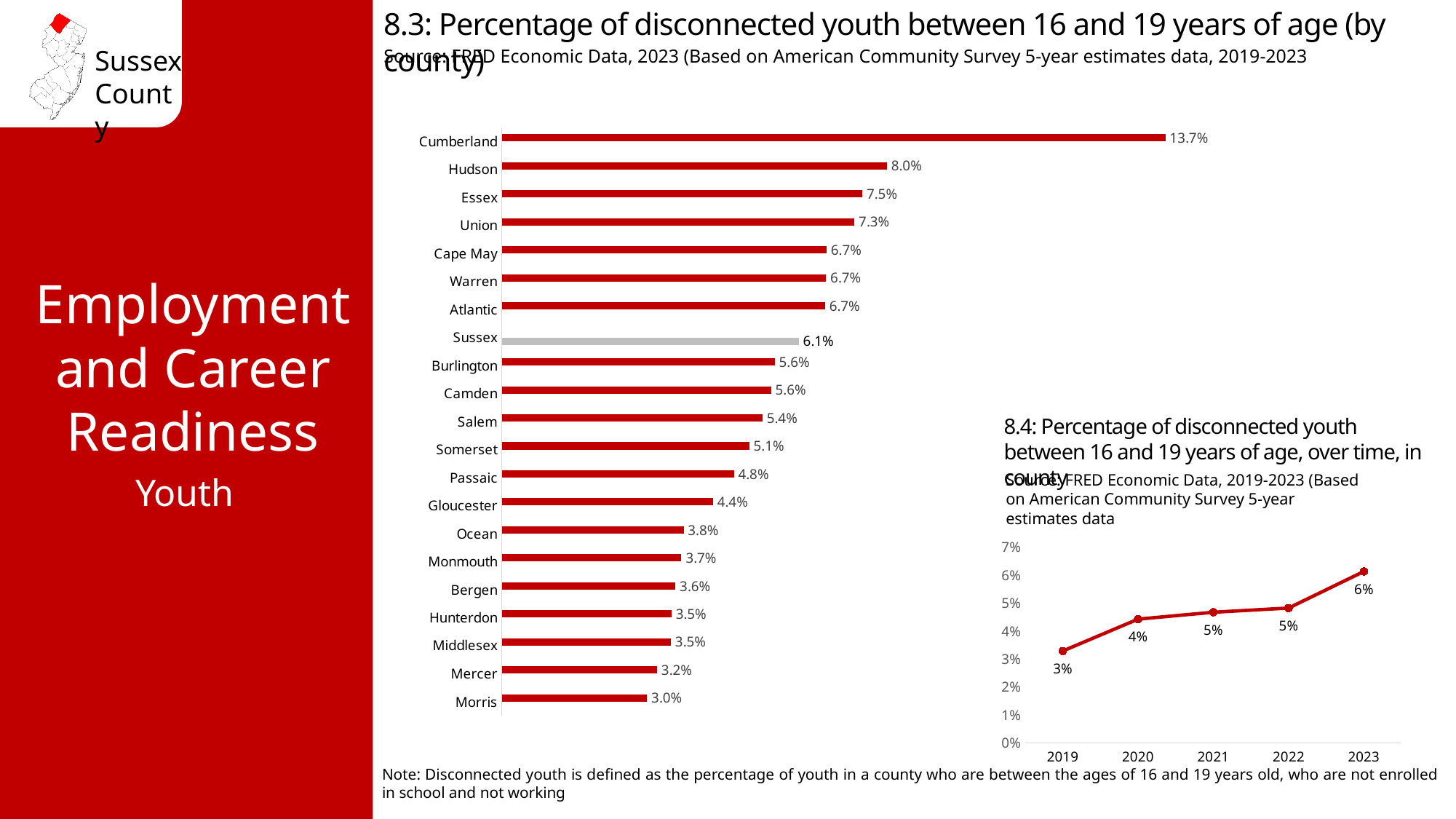
In chart 8.3 (by county), what is the value for Hudson? 8.0% In chart 8.3 (by county), how many counties are shown? 21 In chart 8.3 (by county), what is the percentage of disconnected youth for Sussex? 6.1% In chart 8.3 (by county), which has a higher value, Essex or Union? Essex In chart 8.3 (by county), what is the difference between Cumberland and Hudson? 5.7% In chart 8.3 (by county), which county has the highest percentage of disconnected youth? Cumberland In chart 8.4 (over time, in county), how many years are plotted? 5 In chart 8.3 (by county), which bar is shown in grey rather than red? Sussex In chart 8.4 (over time, in county), what is the value for 2023? 6% In chart 8.3 (by county), which county has the lowest percentage of disconnected youth? Morris In chart 8.4 (over time, in county), do the values rise or fall from 2019 to 2023? Rise What kind of chart is chart 8.3 (by county)? Bar chart